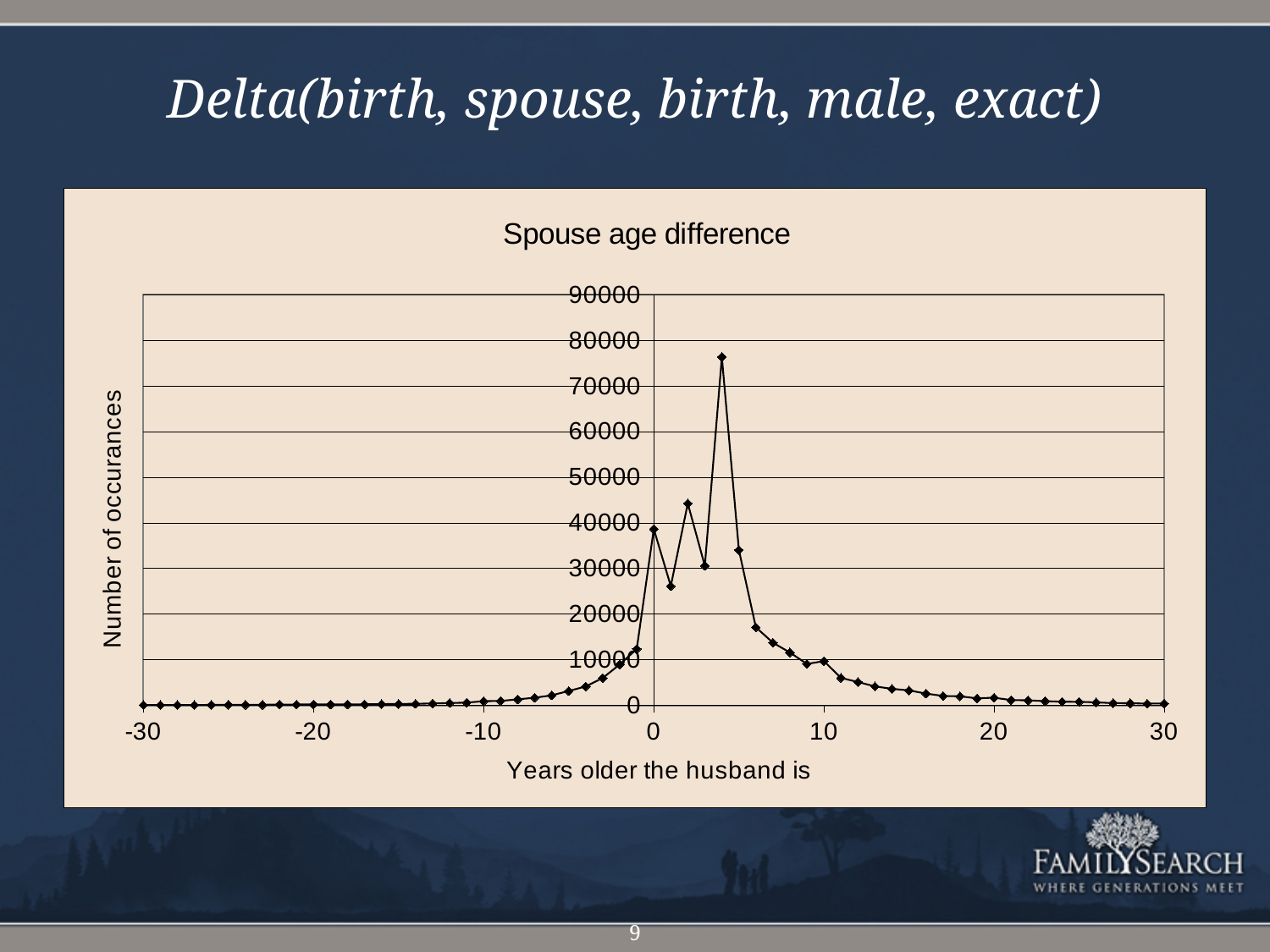
Do the values generally rise or fall as x goes from -30 to 0? rise Is the value at x = 0 greater or less than 30000? greater Is the value at x = 10 greater or less than 20000? less Is the value at x = 2 greater or less than 50000? less At which x-axis value (years older the husband is) does the line reach its highest point? 4 What kind of chart is shown on the slide? line chart Which has the larger value, x = 0 or x = 1? x = 0 What is the label of the x axis? Years older the husband is Do the values generally rise or fall as x goes from 4 to 30? fall What is the title of the chart? Spouse age difference